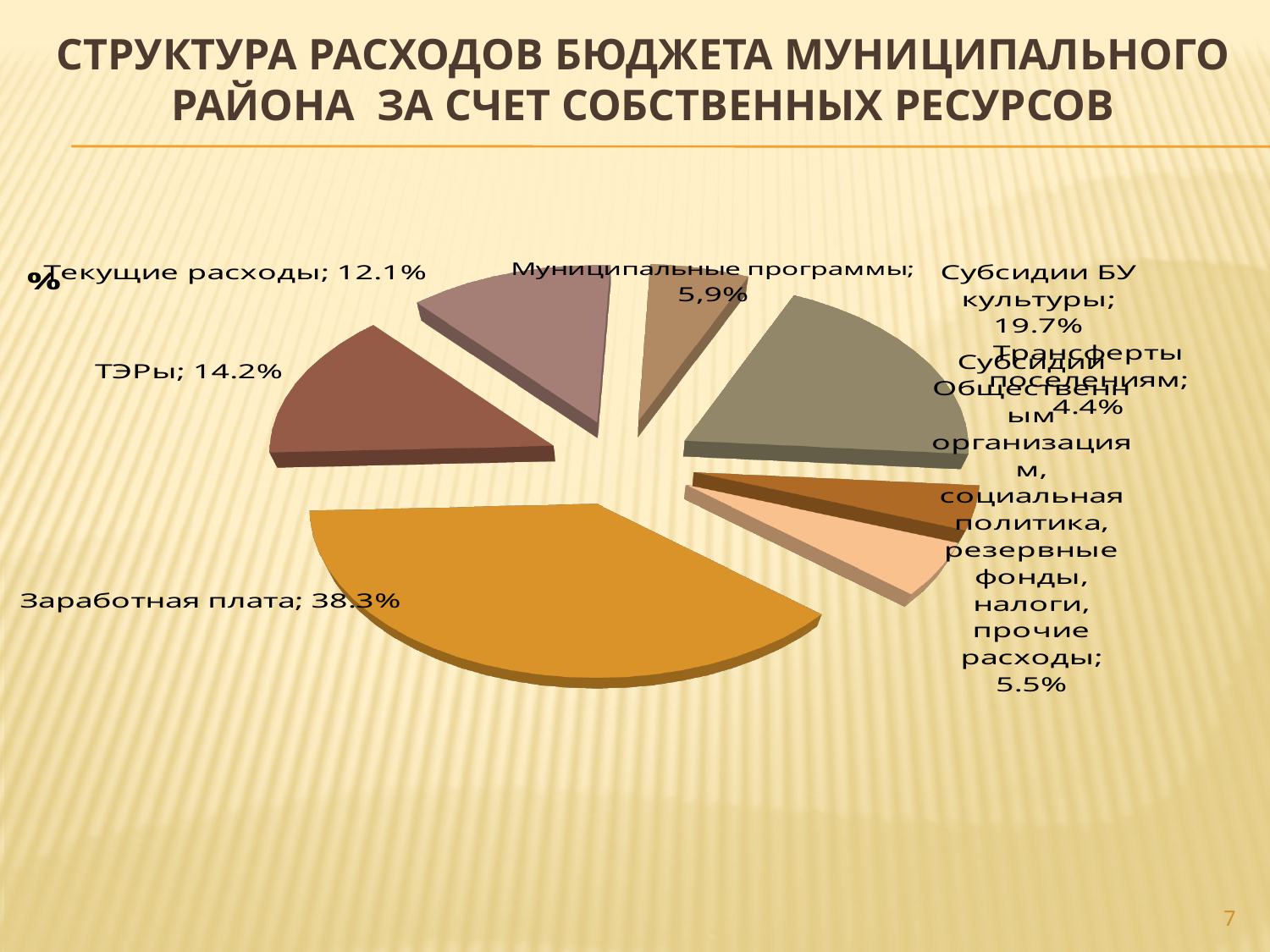
What is the value shown for "Субсидии БУ культуры"? 19.7% What is the difference between the shares for "Заработная плата" and "Субсидии БУ культуры"? 18.6% Which category has the largest slice of the pie? Заработная плата What is the value shown for "Трансферты поселениям"? 4.4% What is the value shown for "ТЭРы"? 14.2% What is the value shown for "Текущие расходы"? 12.1% What is the value shown for "Муниципальные программы"? 5,9% What kind of chart is shown on the slide? pie chart Which category has the smallest slice of the pie? Трансферты поселениям What share of the pie does "Заработная плата" have? 38.3% Which is larger, the share for "ТЭРы" or the share for "Текущие расходы"? ТЭРы How many slices does the pie chart have? 7